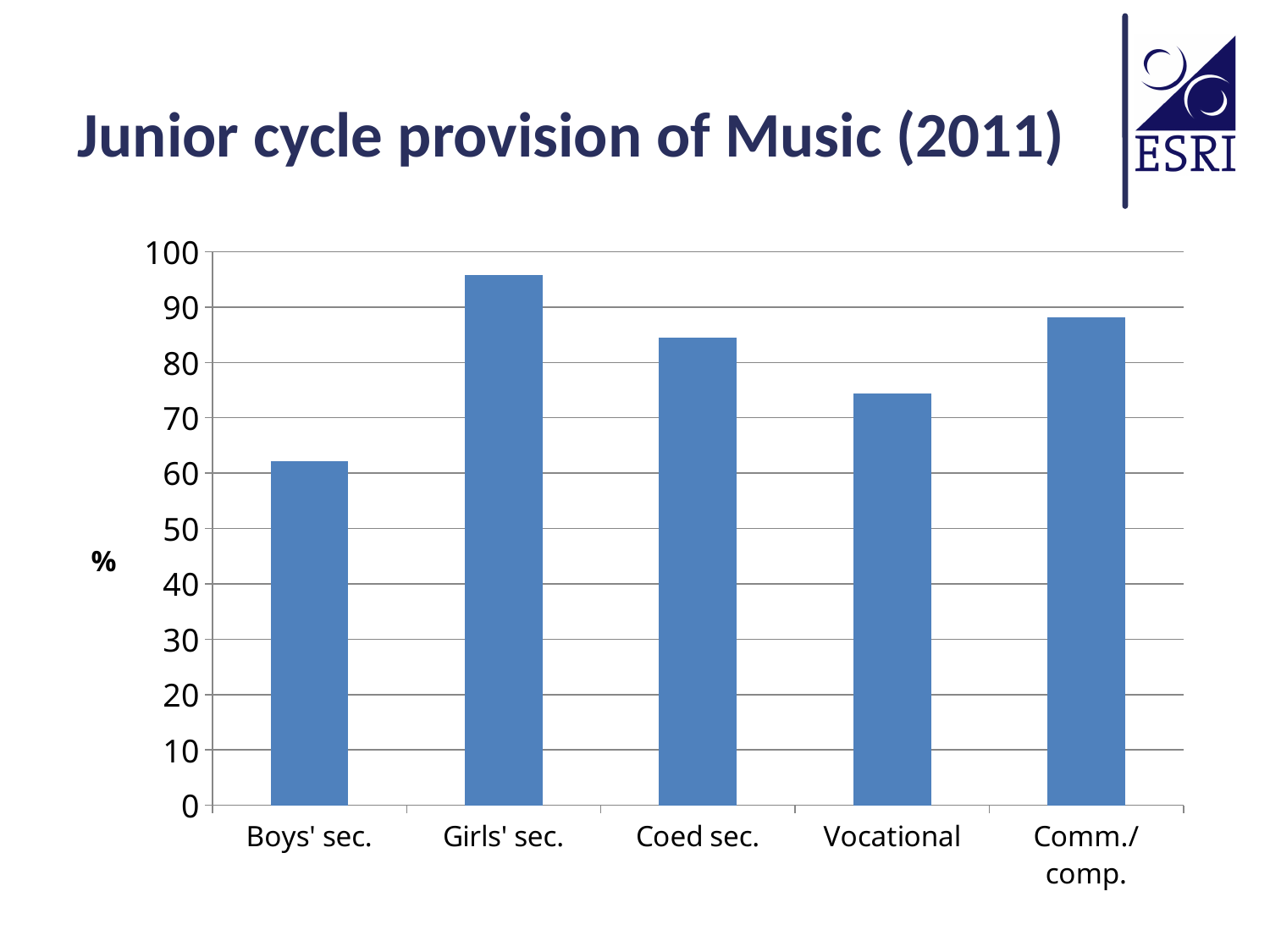
Is the value for Vocational greater or less than 80? less Is the value for Boys' sec. greater or less than 70? less Is the value for Comm./comp. greater or less than 80? greater Which is larger, the value for Coed sec. or the value for Vocational? Coed sec. Which school type has the highest percentage of junior cycle Music provision? Girls' sec. What type of chart is shown on the slide? bar chart Which school type has the lowest percentage of junior cycle Music provision? Boys' sec. Which is larger, the value for Boys' sec. or the value for Vocational? Vocational What is the title of the slide containing the chart? Junior cycle provision of Music (2011) How many school types are shown on the x axis of the chart? 5